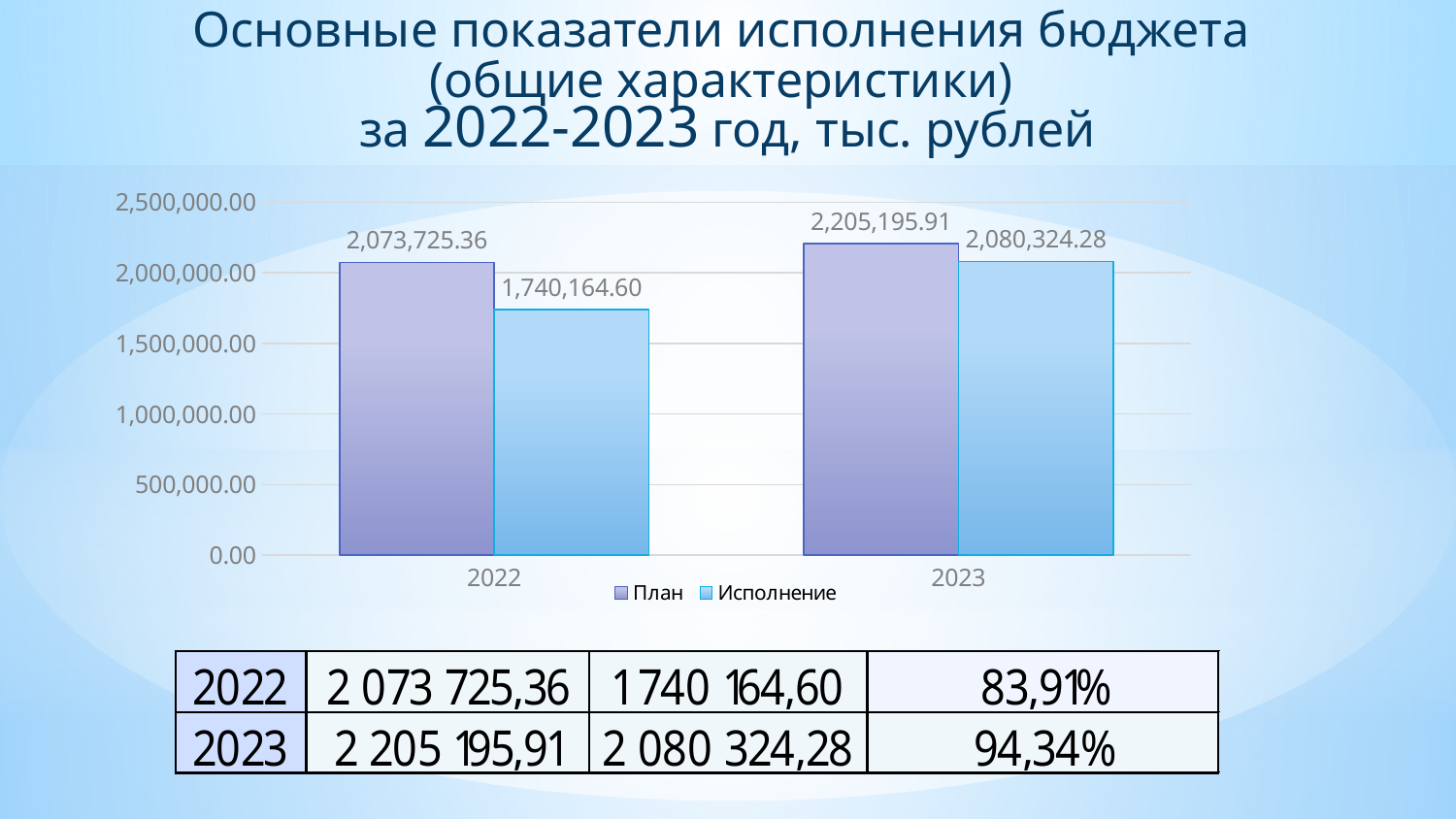
What is the value of План for 2022? 2,073,725.36 Which bar in the chart has the lowest value? Исполнение for 2022 What is the difference between План and Исполнение for 2022? 333,560.76 What type of chart is shown on the slide? bar chart What is the value of Исполнение for 2022? 1,740,164.60 What is the value of План for 2023? 2,205,195.91 Which year has the higher Исполнение value? 2023 What is the value of Исполнение for 2023? 2,080,324.28 What is the difference between План and Исполнение for 2023? 124,871.63 How many series does the legend list? 2 How many categories are shown on the x axis? 2 Is the value of Исполнение for 2022 greater or less than 2,000,000.00? less